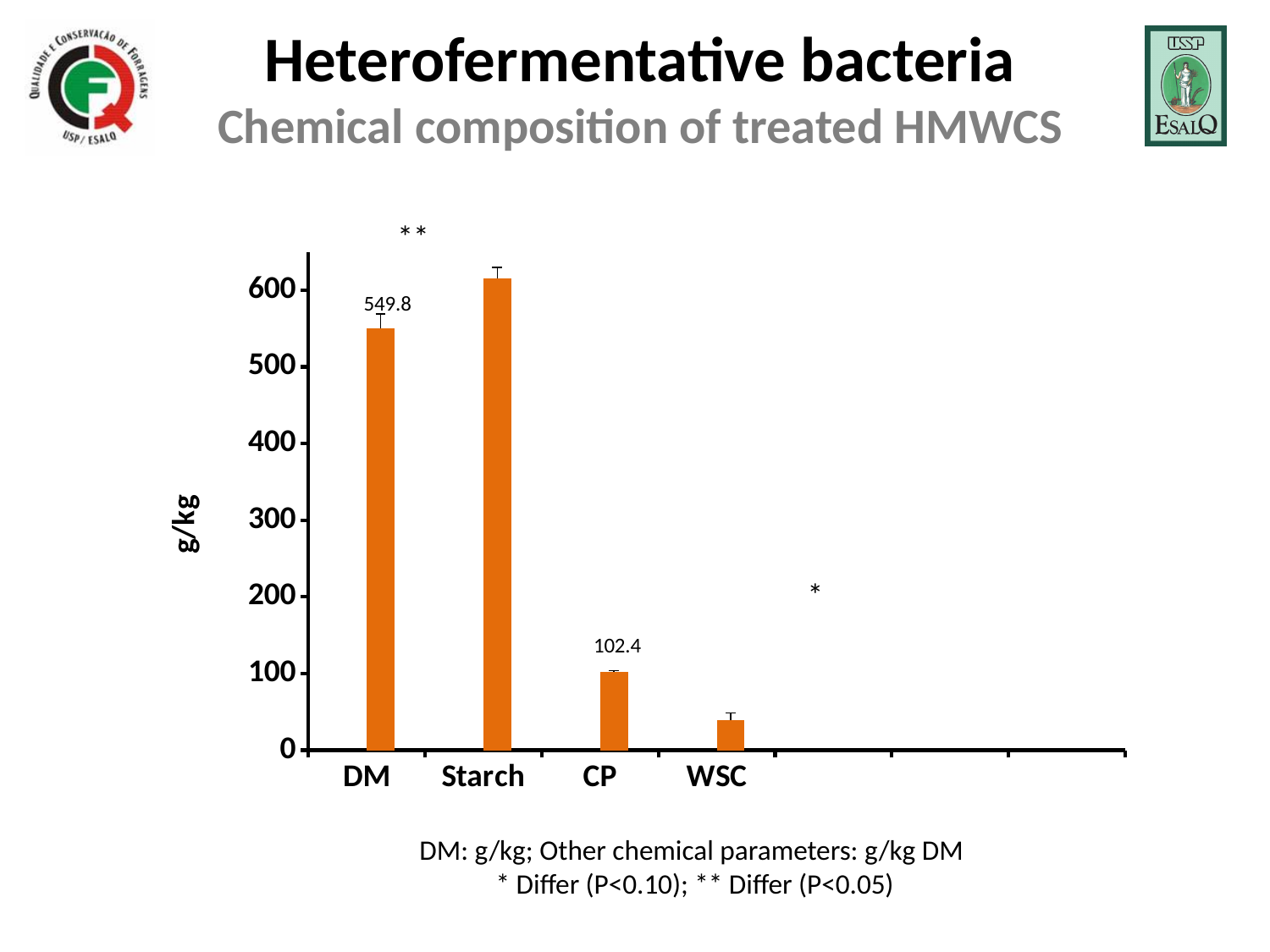
What is the value for DM? 549.8 What is the value for CP? 102.4 What kind of chart is shown on the slide? bar chart Which is larger, the value for CP or the value for WSC? CP Is the value for Starch greater or less than 600? greater How many categories are shown on the x axis? 4 Which category has the highest bar? Starch Is the value for WSC greater or less than 100? less Which is larger, the value for DM or the value for Starch? Starch Which category has the lowest bar? WSC What is the difference between the values for DM and CP? 447.4 What is the label of the y axis? g/kg